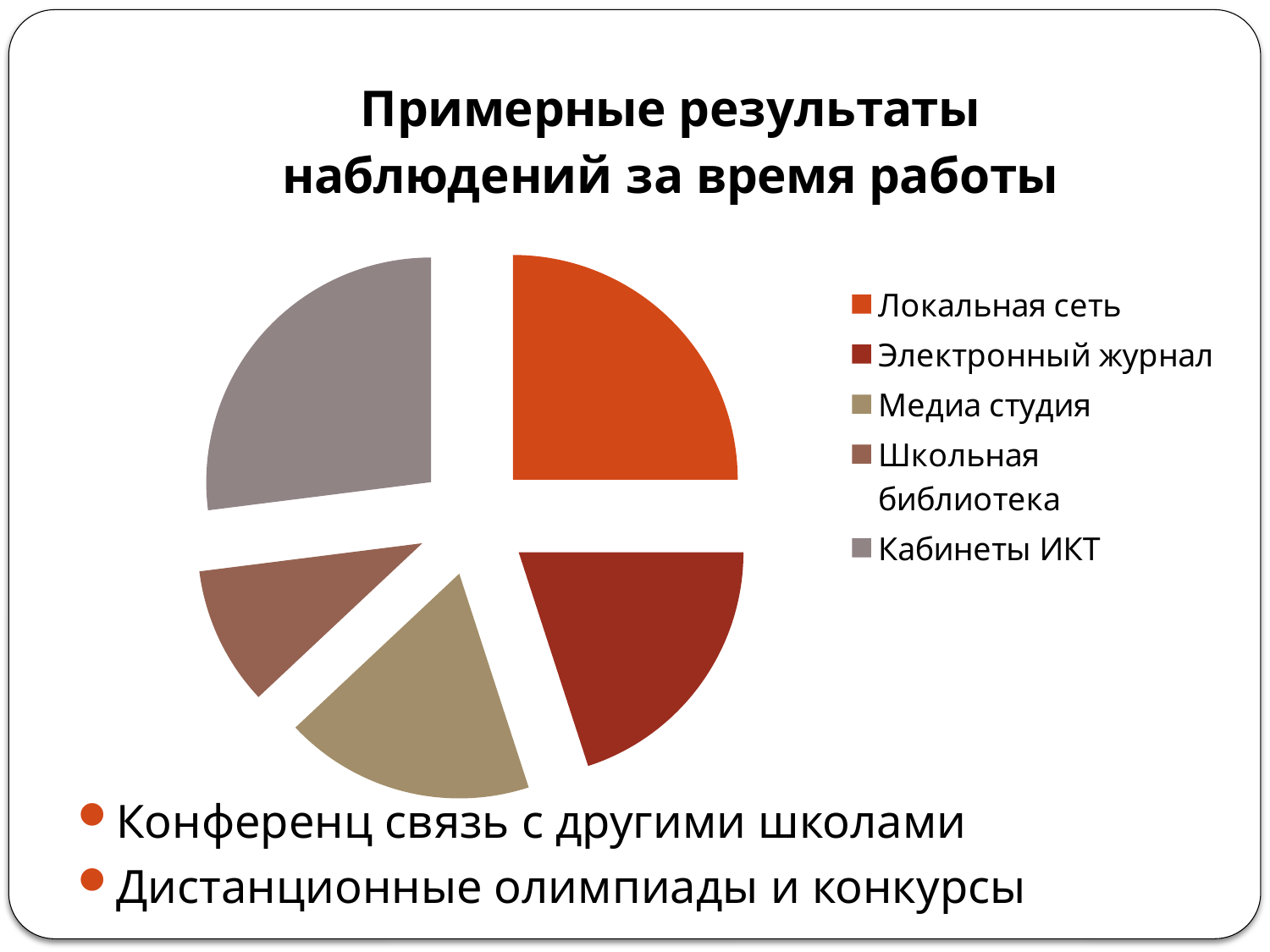
How many entries does the legend of the pie chart list? 5 Which slice is larger, Локальная сеть or Электронный журнал? Локальная сеть Which slice is larger, Кабинеты ИКТ or Медиа студия? Кабинеты ИКТ How many slices does the pie chart have? 5 Which slice is larger, Локальная сеть or Медиа студия? Локальная сеть What kind of chart is shown on the slide? pie chart Which legend entry is shown in orange in the pie chart? Локальная сеть What is the title of the chart on the slide? Примерные результаты наблюдений за время работы